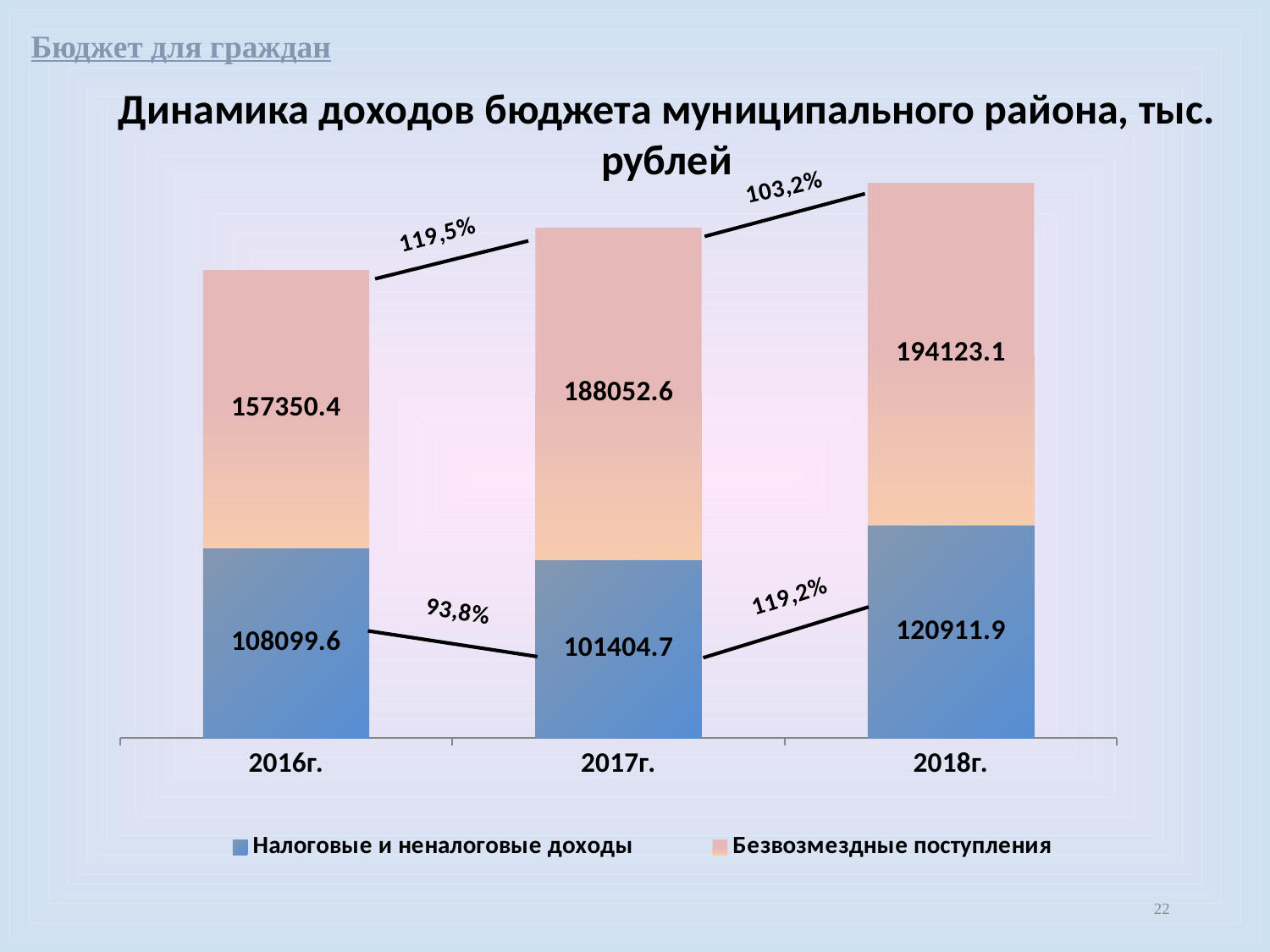
What is the value of Налоговые и неналоговые доходы for 2016г.? 108099.6 What is the difference between Безвозмездные поступления in 2017г. and 2016г.? 30702.2 In which year is Налоговые и неналоговые доходы the lowest? 2017г. What type of chart is shown on the slide? Stacked bar chart What is the total of the stacked bar for 2018г.? 315035.0 What percentage is shown on the line connecting Безвозмездные поступления from 2016г. to 2017г.? 119,5% What is the difference between Налоговые и неналоговые доходы in 2018г. and 2017г.? 19507.2 What is the value of Безвозмездные поступления for 2017г.? 188052.6 In which year is Безвозмездные поступления the highest? 2018г. What is the value of Безвозмездные поступления for 2018г.? 194123.1 Which is larger in 2016г.: Налоговые и неналоговые доходы or Безвозмездные поступления? Безвозмездные поступления How many series does the legend list? 2